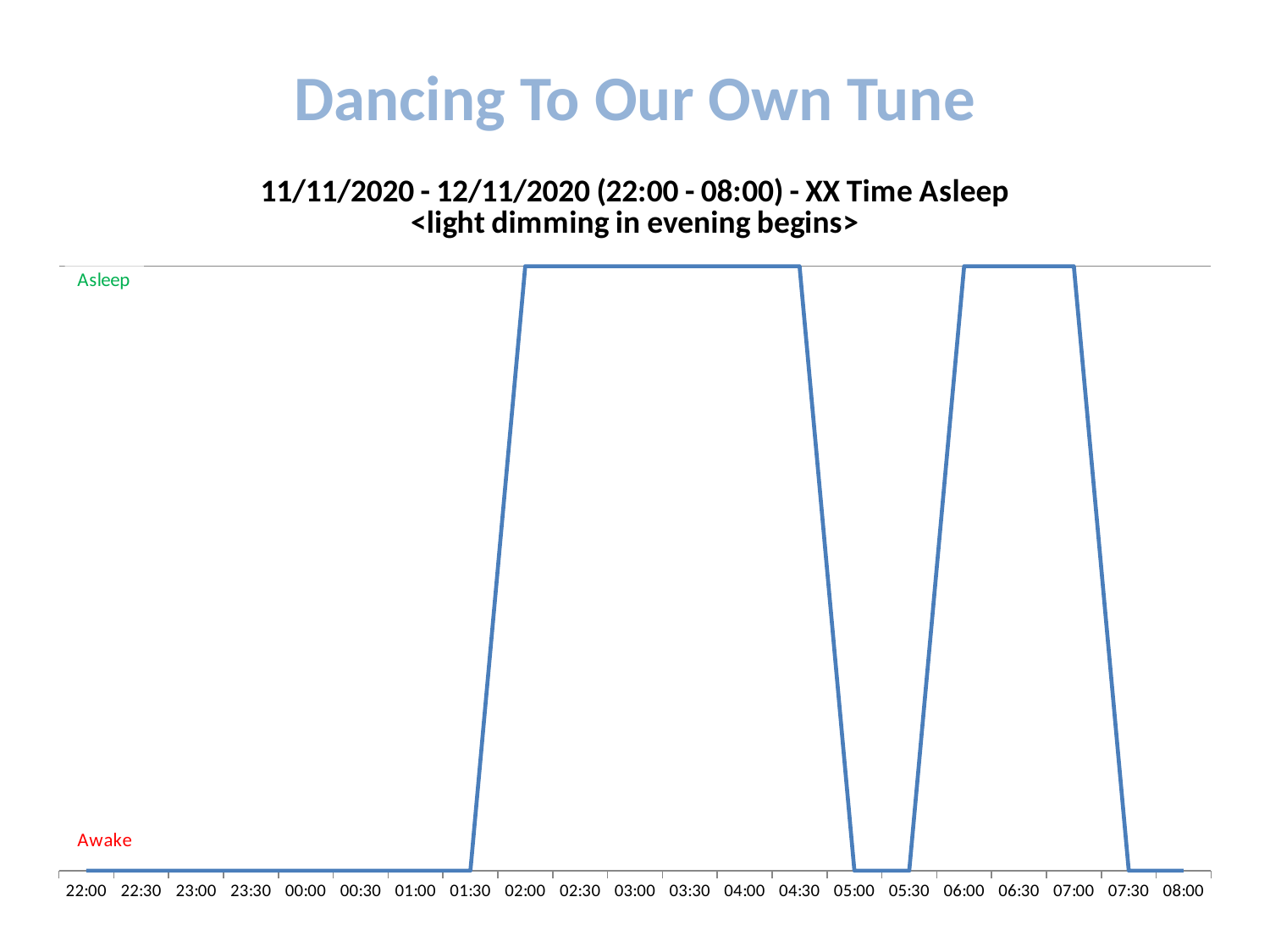
What is the state shown at 06:30? Asleep What is the state shown at 05:00? Awake What is the state shown at 03:00? Asleep How many separate periods at the Asleep level does the line show? 2 What is the state shown at 23:00? Awake What are the two labels on the y axis? Asleep and Awake Does the line rise or fall between 01:30 and 02:00? rise How many time points are labelled on the x axis? 21 What is the title of the chart? 11/11/2020 - 12/11/2020 (22:00 - 08:00) - XX Time Asleep <light dimming in evening begins> What kind of chart is shown on the slide? line chart At what time does the line first reach the Asleep level? 02:00 What is the state shown at 08:00? Awake